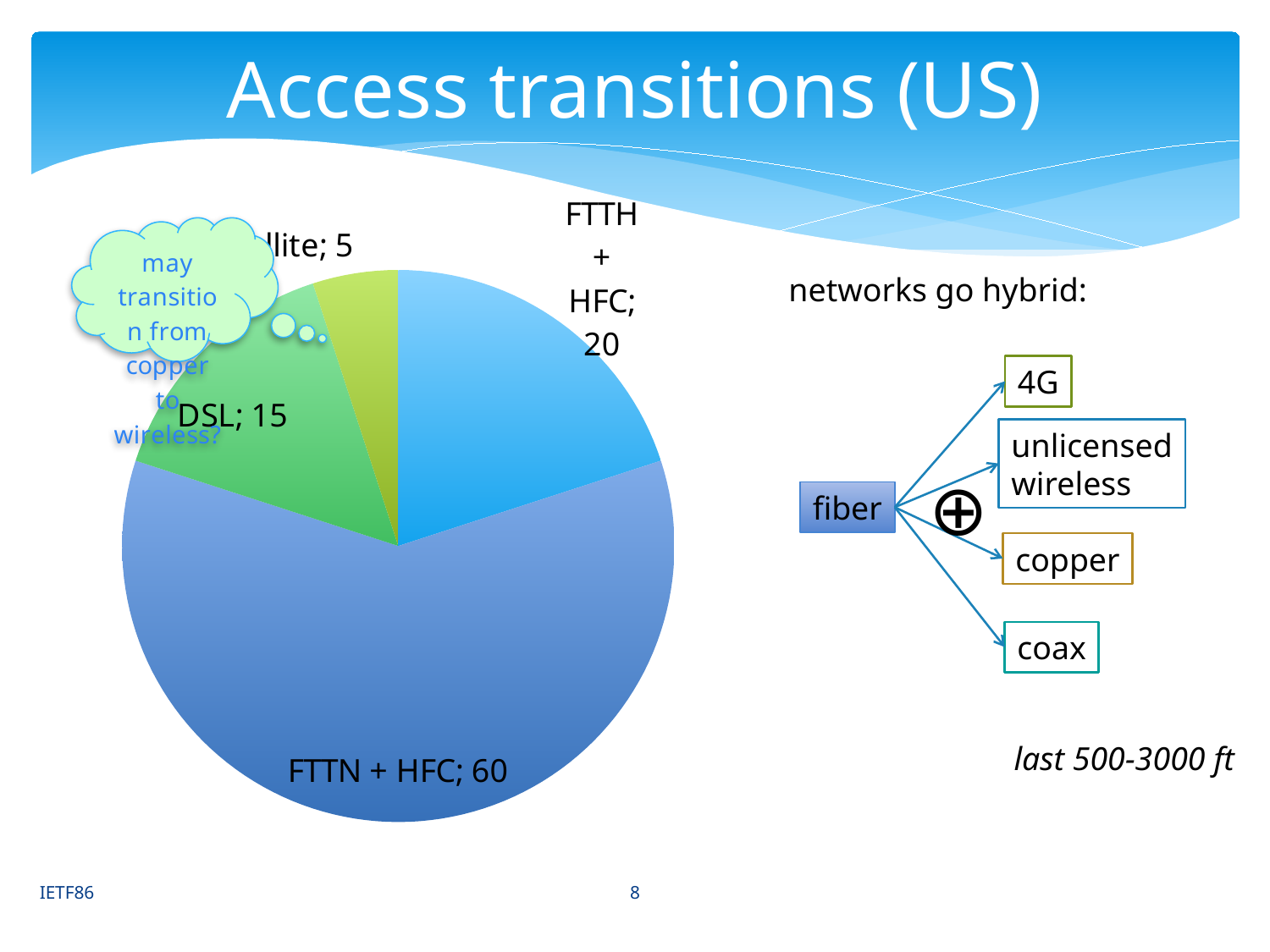
What share of the pie does FTTN + HFC represent? 60% What is the difference between the values for FTTN + HFC and FTTH + HFC? 40 What colour is the FTTN + HFC slice of the pie chart? blue What is the value for FTTN + HFC in the pie chart? 60 Which category has the largest slice of the pie chart? FTTN + HFC What is the value for FTTH + HFC in the pie chart? 20 How many slices does the pie chart have? 4 What is the difference between the values for FTTH + HFC and DSL? 5 Which is larger, the value for DSL or the value for FTTH + HFC? FTTH + HFC What kind of chart is shown on the slide? pie chart What is the value for DSL in the pie chart? 15 What share of the pie does DSL represent? 15%